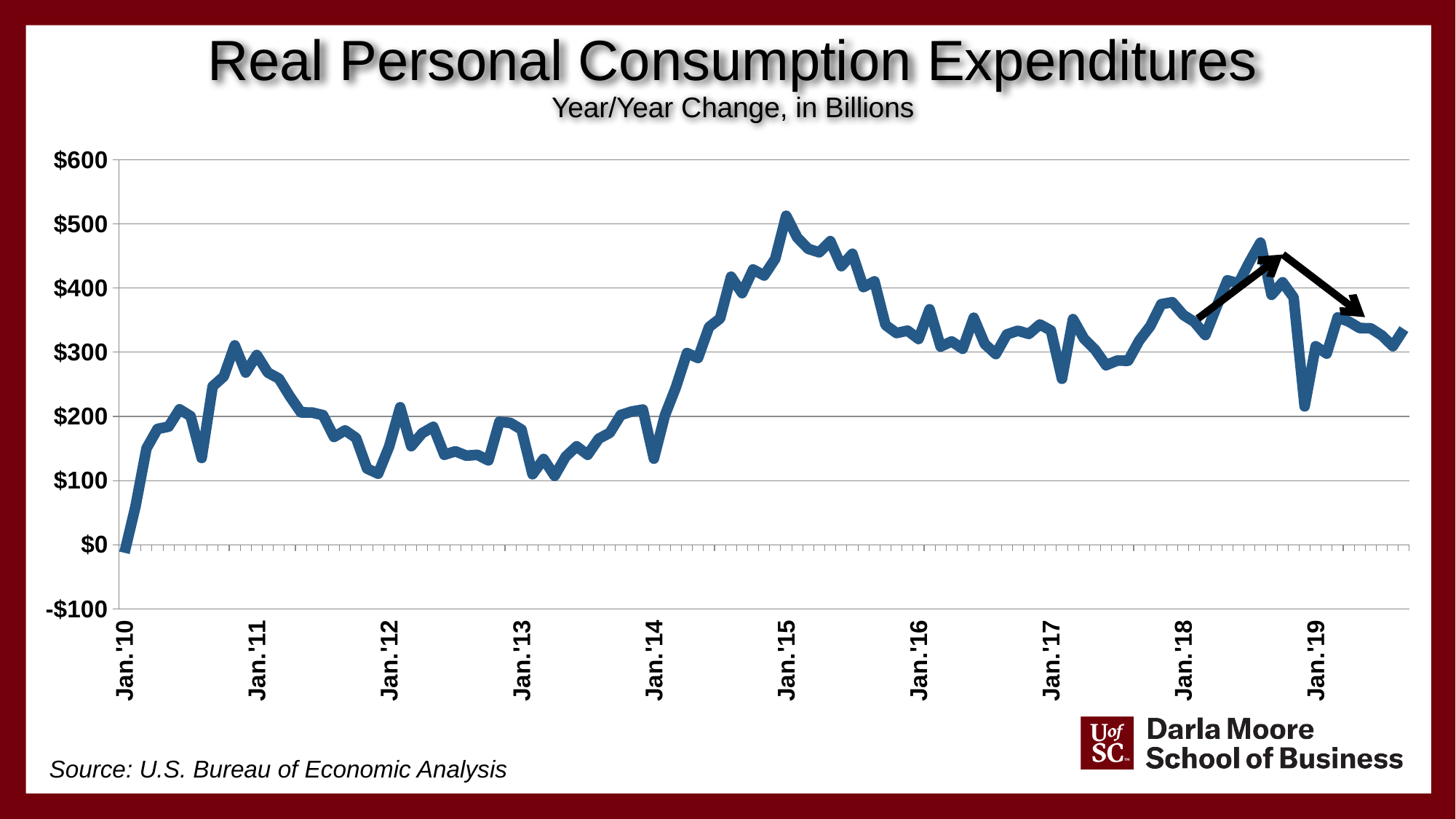
At which x-axis label does the line reach its lowest point? Jan '10 At which x-axis label does the line reach its highest point? Jan '15 Is the value at Jan '10 greater or less than $0? less Is the value at Jan '17 greater or less than $300? greater Is the value at Jan '15 greater or less than $500? greater What kind of chart is shown on the slide? line chart What source is cited for the chart data? U.S. Bureau of Economic Analysis What is the title of the chart? Real Personal Consumption Expenditures Does the line rise or fall between Jan '14 and Jan '15? rise